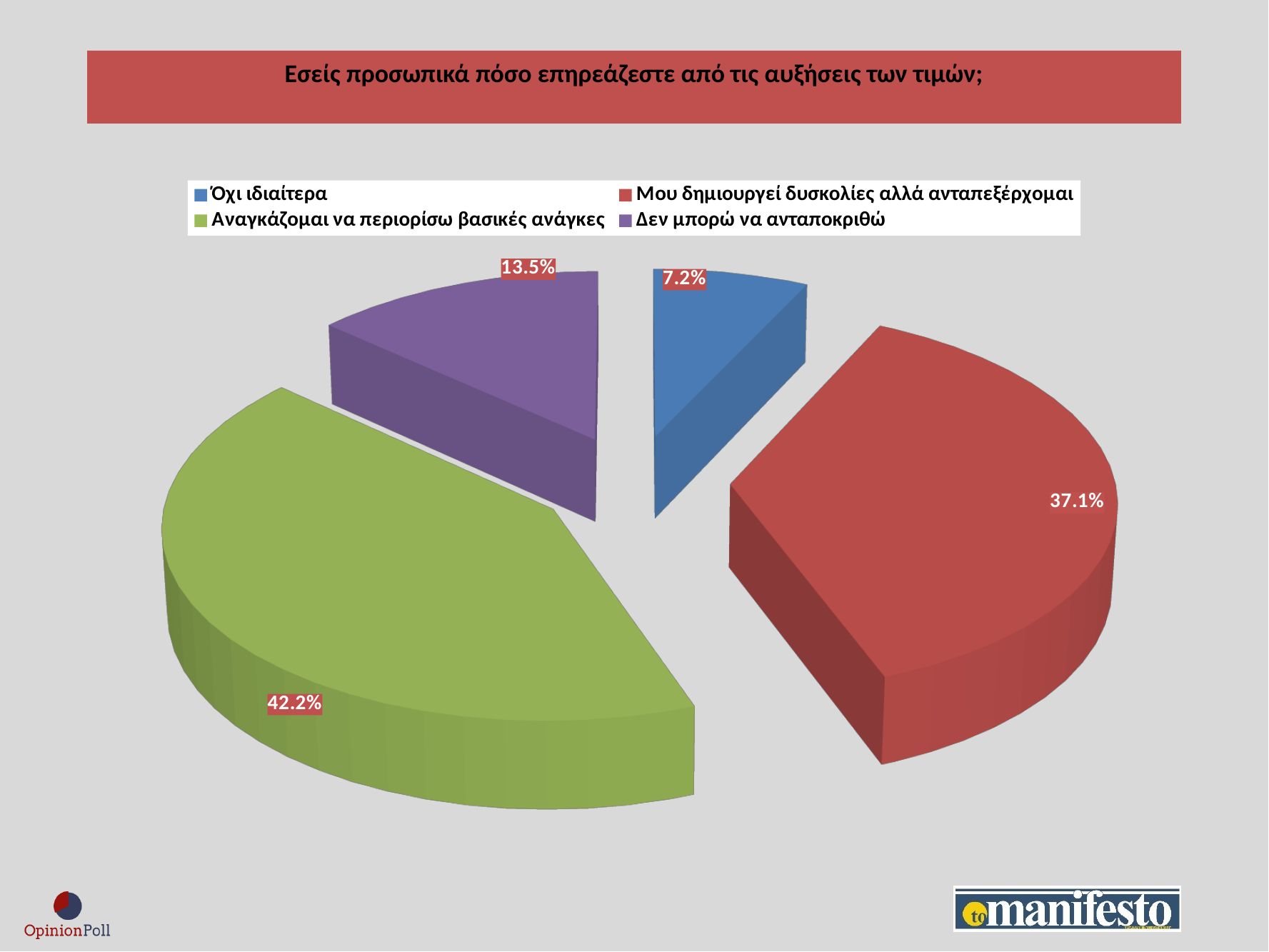
Which category has the smallest share of the pie? Όχι ιδιαίτερα What is the value for 'Μου δημιουργεί δυσκολίες αλλά ανταπεξέρχομαι'? 37.1% What is the value for 'Αναγκάζομαι να περιορίσω βασικές ανάγκες'? 42.2% What is the value for 'Όχι ιδιαίτερα'? 7.2% Which category has the largest share of the pie? Αναγκάζομαι να περιορίσω βασικές ανάγκες What is the difference between the values for 'Αναγκάζομαι να περιορίσω βασικές ανάγκες' and 'Μου δημιουργεί δυσκολίες αλλά ανταπεξέρχομαι'? 5.1% How many slices does the pie chart have? 4 What type of chart is shown on the slide? Pie chart Which is larger: the value for 'Δεν μπορώ να ανταποκριθώ' or the value for 'Όχι ιδιαίτερα'? Δεν μπορώ να ανταποκριθώ What is the value for 'Δεν μπορώ να ανταποκριθώ'? 13.5% What colour is the slice for 'Μου δημιουργεί δυσκολίες αλλά ανταπεξέρχομαι'? Red What is the title of the chart? Εσείς προσωπικά πόσο επηρεάζεστε από τις αυξήσεις των τιμών;